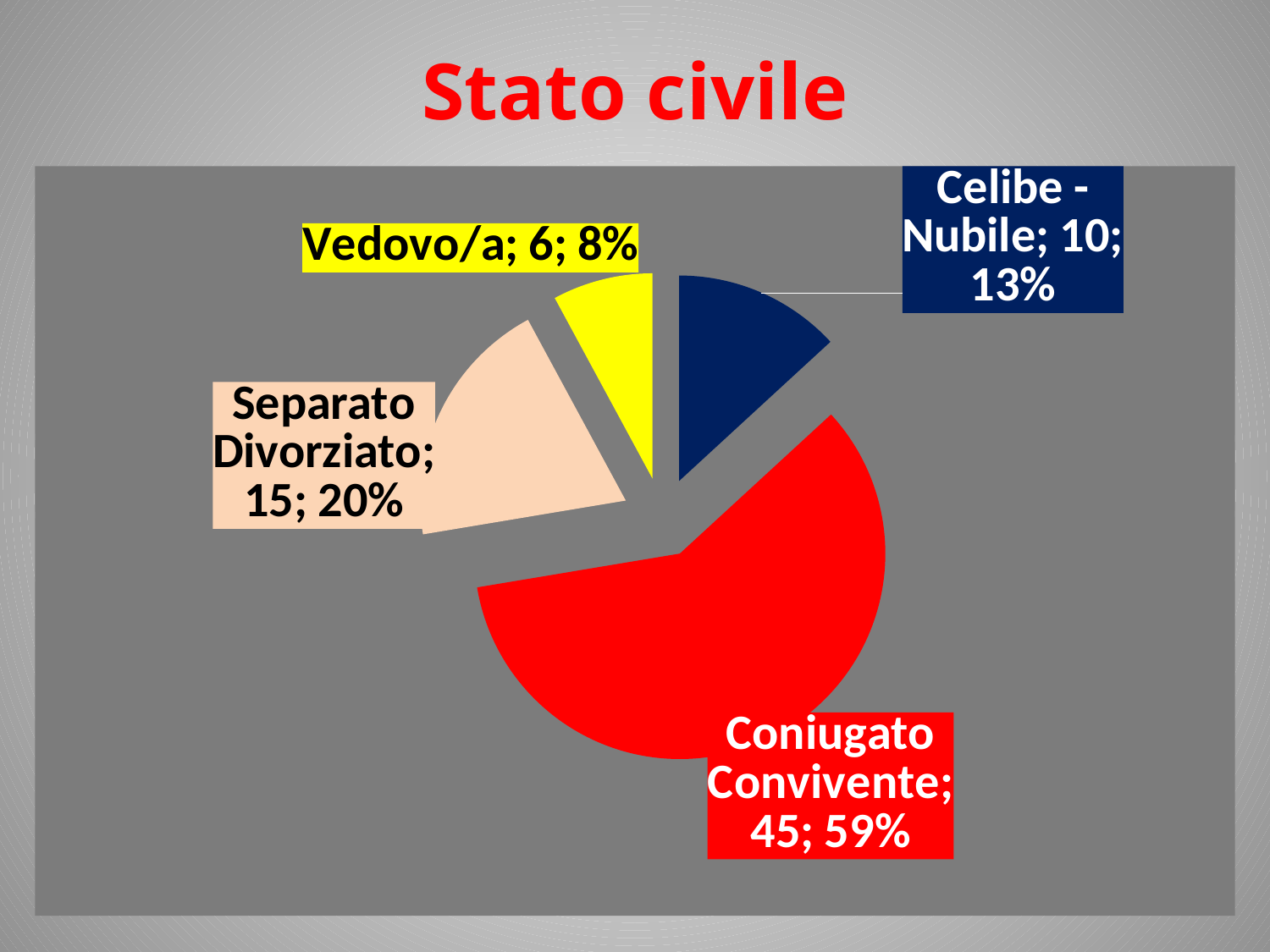
Which is larger, the count for Celibe - Nubile or the count for Vedovo/a? Celibe - Nubile What is the difference in count between Separato Divorziato and Celibe - Nubile? 5 How many slices does the pie chart have? 4 What colour is the Coniugato Convivente slice? Red What percentage share does Celibe - Nubile have? 13% What is the title of the chart? Stato civile What is the count for Coniugato Convivente? 45 What is the count for Vedovo/a? 6 Which category has the largest slice? Coniugato Convivente What percentage share does Separato Divorziato have? 20% Which category has the smallest slice? Vedovo/a What kind of chart is shown on the slide? Pie chart